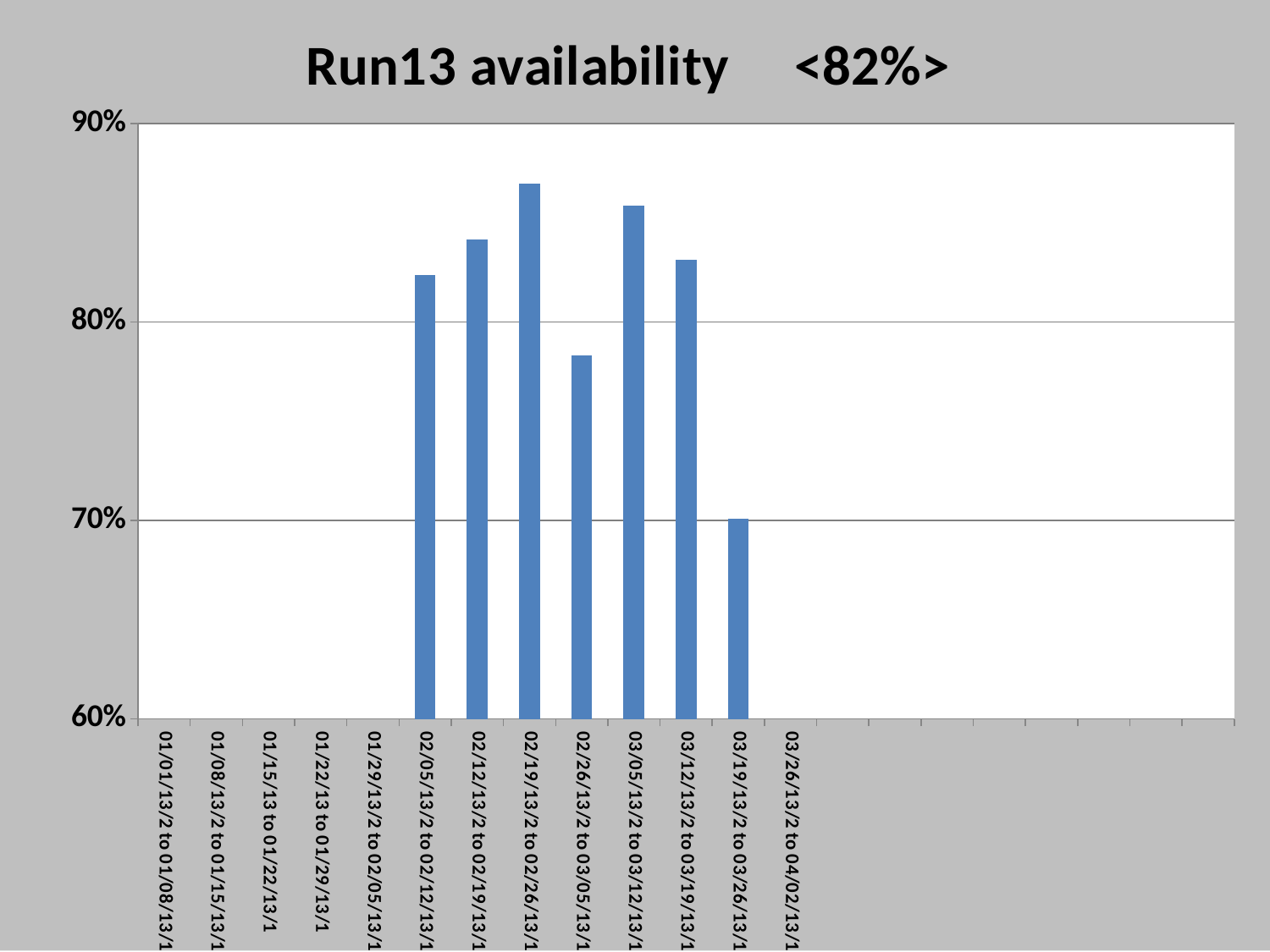
Is the availability for the week starting 03/12/13 greater or less than 90%? less How many bars are plotted in the chart? 7 Is the availability for the week starting 02/05/13 greater or less than 80%? greater Which is higher, the availability for the week starting 02/12/13 or the week starting 02/26/13? 02/12/13/2 to 02/19/13/1 What is the lowest value shown on the vertical axis? 60% Which week has the highest availability? 02/19/13/2 to 02/26/13/1 Which week has the lowest availability? 03/19/13/2 to 03/26/13/1 Is the availability for the week starting 02/26/13 greater or less than 80%? less What kind of chart is shown on the slide? bar chart Which is higher, the availability for the week starting 03/05/13 or the week starting 03/19/13? 03/05/13/2 to 03/12/13/1 What is the title of the chart? Run13 availability <82%>